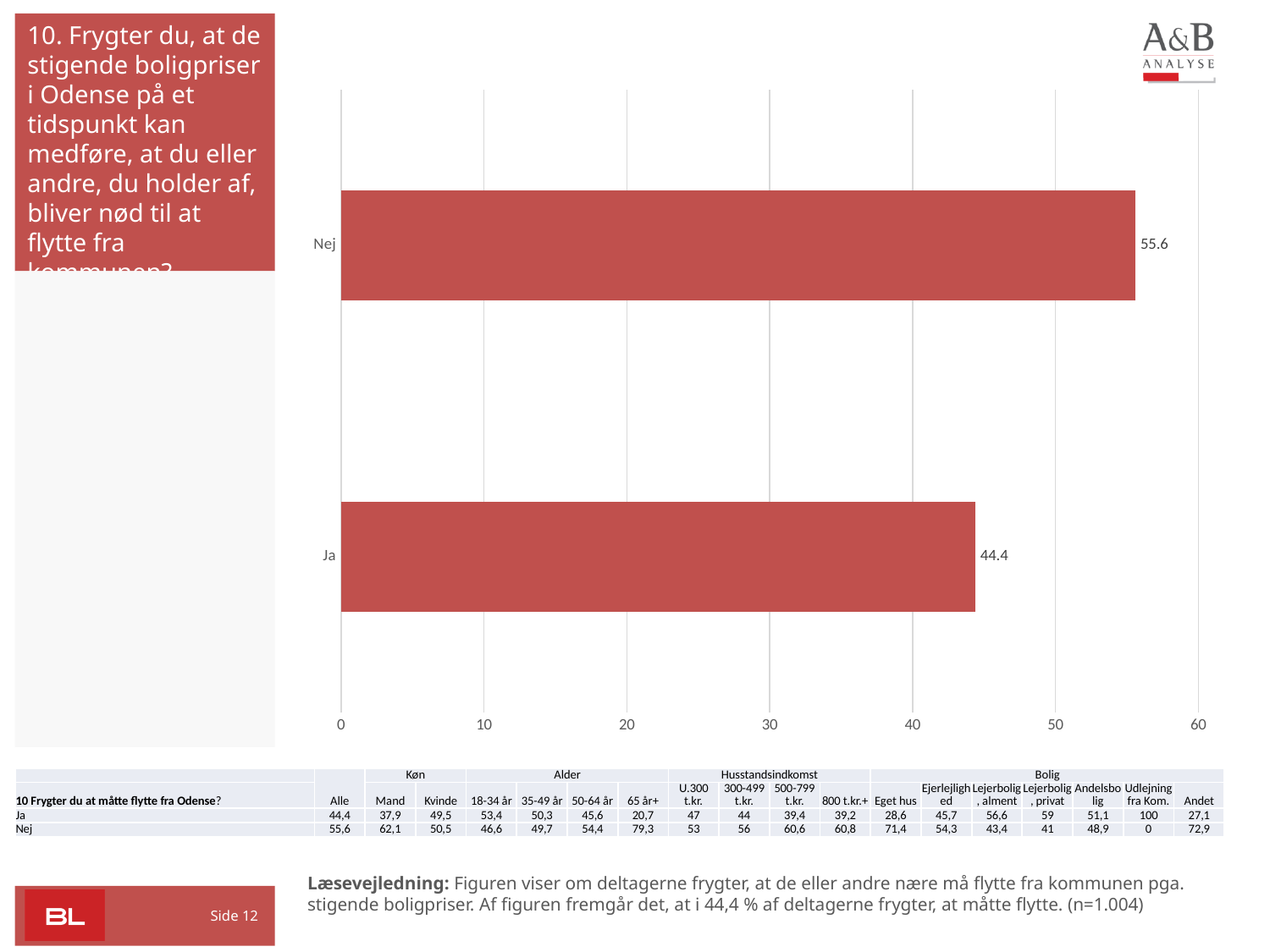
What is the highest value shown on the chart's horizontal axis? 60 What is the total of the values for "Ja" and "Nej"? 100 Which category has the highest value? Nej What is the difference between the values for "Nej" and "Ja"? 11.2 Is the value for "Ja" greater or less than 50? less What is the value for "Ja"? 44.4 Which is larger, the value for "Ja" or the value for "Nej"? Nej What is the value for "Nej"? 55.6 Is the value for "Nej" greater or less than 50? greater How many categories are shown in the chart? 2 What kind of chart is shown on the slide? bar chart Which category has the lowest value? Ja